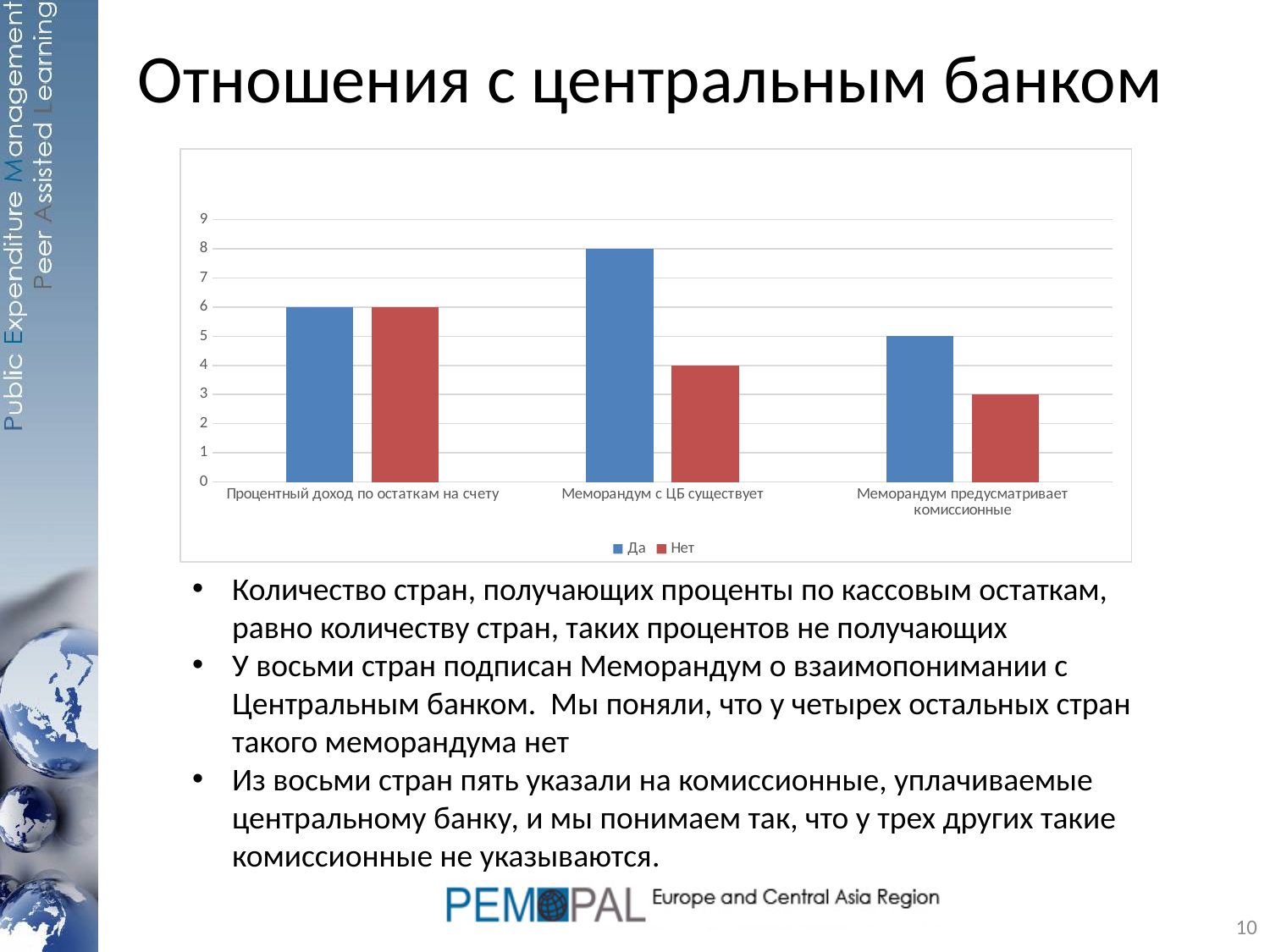
How many series does the legend list? 2 What kind of chart is shown on the slide? bar chart How many categories are shown on the x axis? 3 What is the value of "Да" for "Процентный доход по остаткам на счету"? 6 What is the value of "Нет" for "Меморандум с ЦБ существует"? 4 What is the value of "Да" for "Меморандум предусматривает комиссионные"? 5 What is the difference between "Да" and "Нет" for "Меморандум с ЦБ существует"? 4 Which category has the lowest "Нет" value? Меморандум предусматривает комиссионные What is the value of "Да" for "Меморандум с ЦБ существует"? 8 Which category has the highest "Да" value? Меморандум с ЦБ существует What is the value of "Нет" for "Меморандум предусматривает комиссионные"? 3 Which legend entry is shown in blue? Да